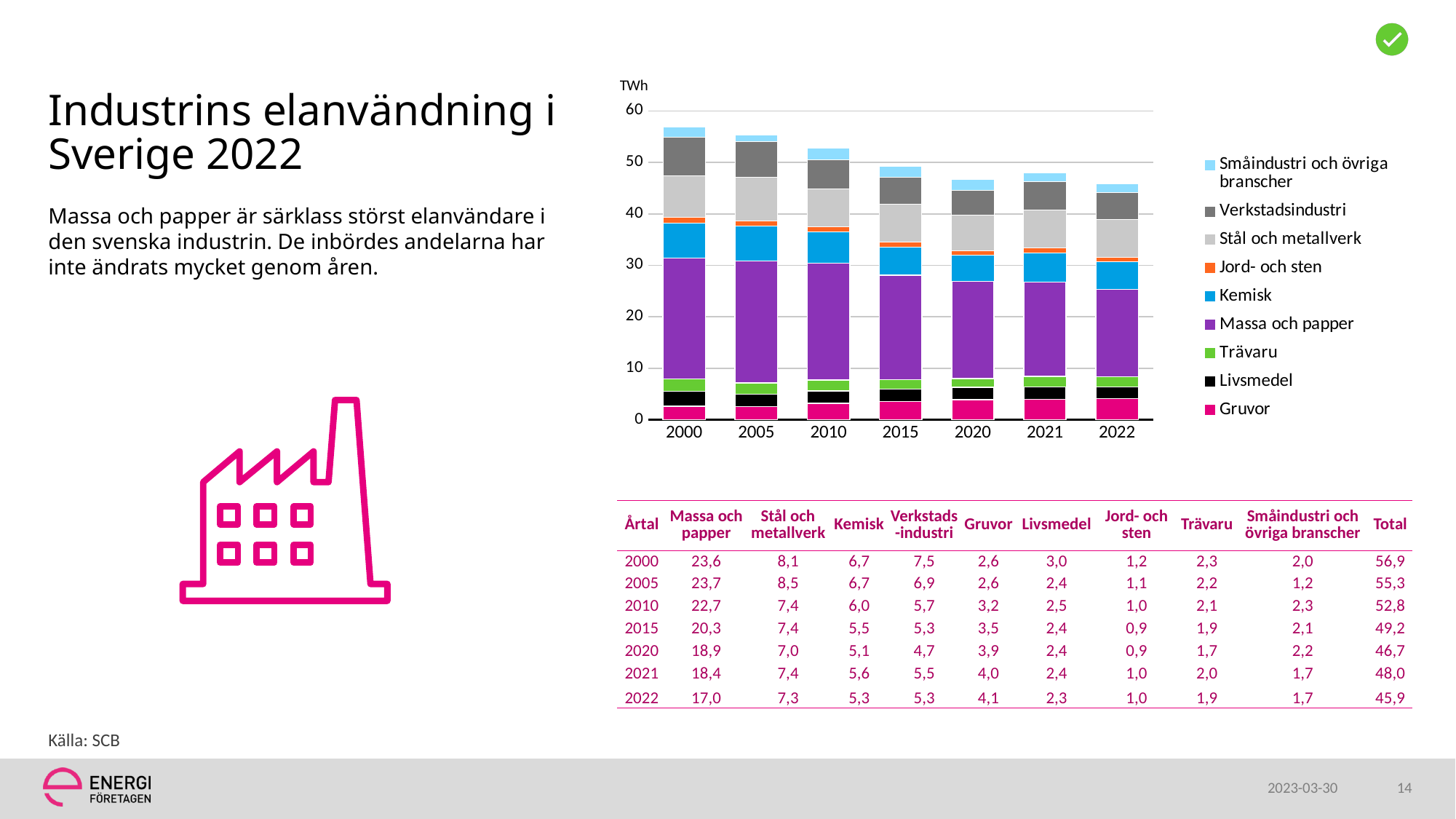
What is the value for Massa och papper in 2022? 17,0 What kind of chart is shown on the slide? Stacked bar chart What is the difference between the Massa och papper values for 2000 and 2022? 6,6 Does the total electricity use rise or fall from 2000 to 2022? Fall Is the total for the 2015 bar greater or less than 50? less What is the total electricity use (Total) for the 2000 bar? 56,9 Which year has the highest total electricity use? 2000 What unit is shown on the y axis of the chart? TWh How many years (bars) are shown on the x axis of the chart? 7 Which year has the lowest total electricity use? 2022 How many series does the chart legend list? 9 Which is larger, the Gruvor value in 2022 or the Gruvor value in 2000? 2022